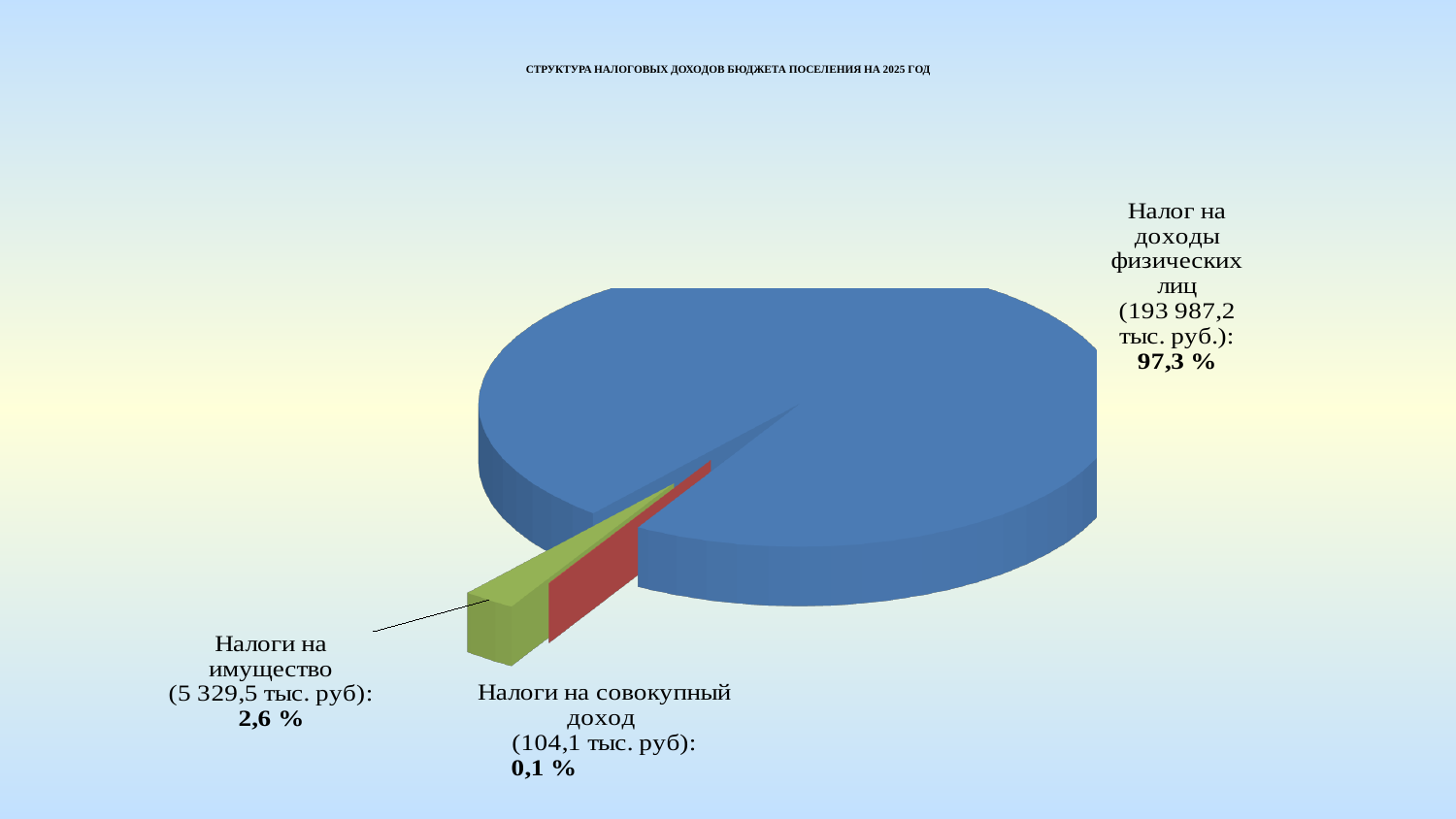
What share of the pie does "Налоги на совокупный доход" represent? 0,1 % What amount in тыс. руб. is shown for "Налоги на совокупный доход"? 104,1 тыс. руб. What share of the pie does "Налоги на имущество" represent? 2,6 % How many slices does the pie chart have? 3 What amount in тыс. руб. is shown for "Налоги на имущество"? 5 329,5 тыс. руб. What share of the pie does "Налог на доходы физических лиц" represent? 97,3 % What is the difference in percentage points between the share of "Налог на доходы физических лиц" and the share of "Налоги на имущество"? 94,7 % Which is larger: the share for "Налоги на имущество" or for "Налоги на совокупный доход"? Налоги на имущество What amount in тыс. руб. is shown for "Налог на доходы физических лиц"? 193 987,2 тыс. руб. Which category has the smallest share of the pie? Налоги на совокупный доход Which category has the largest share of the pie? Налог на доходы физических лиц What kind of chart is shown on the slide? Pie chart